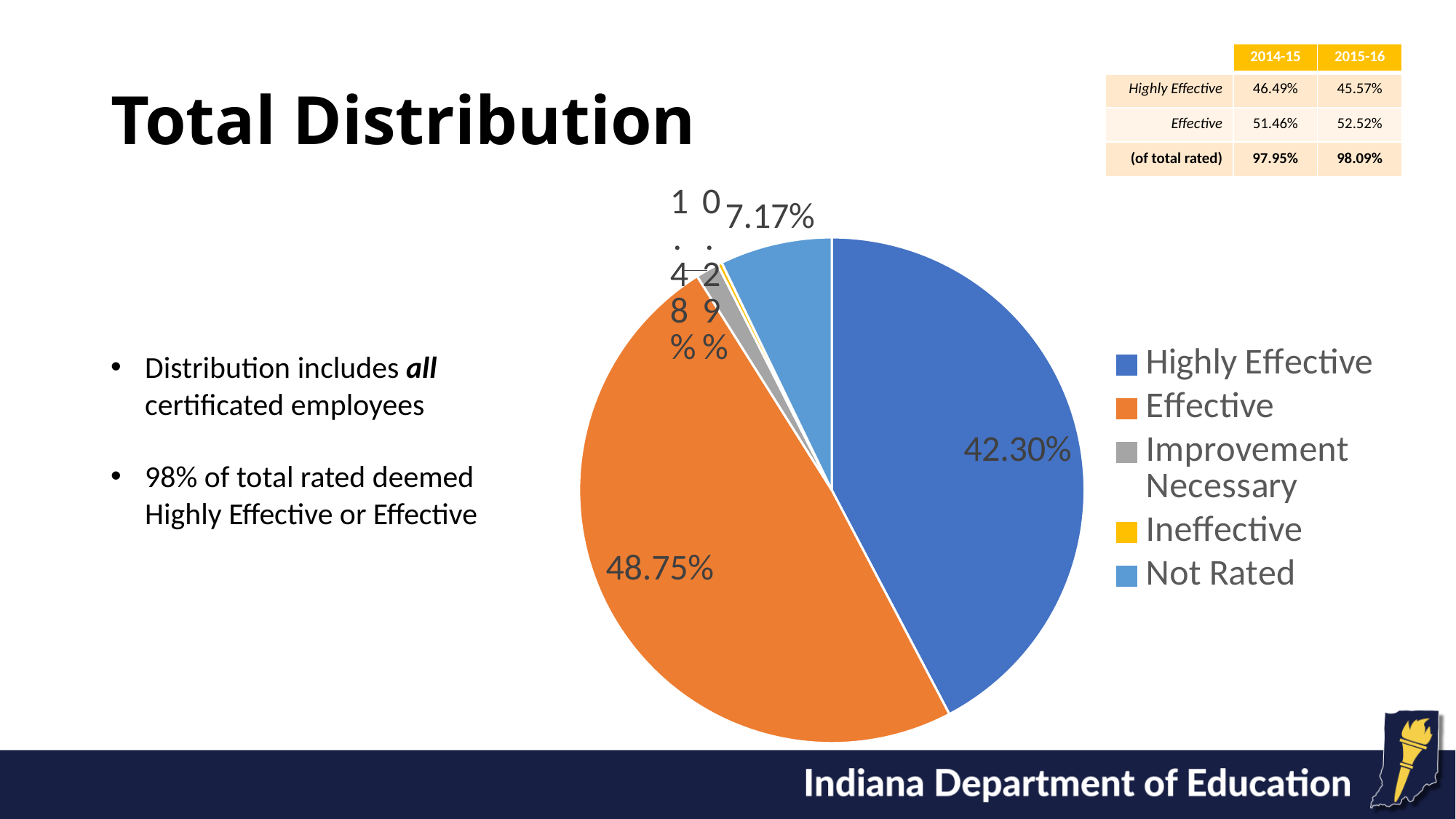
Which slice is larger in the pie chart, Highly Effective or Not Rated? Highly Effective What is the difference between the Effective and Highly Effective percentages in the pie chart? 6.45% What percentage of the pie chart is labelled for Improvement Necessary? 1.48% What colour is the Not Rated slice in the pie chart? Light blue Which category has the largest slice of the pie chart? Effective What colour is the Effective slice in the pie chart? Orange How many categories does the legend of the pie chart list? 5 What kind of chart is shown on the slide? Pie chart What percentage of the pie chart is labelled for Not Rated? 7.17% Which category has the smallest slice of the pie chart? Ineffective What percentage of the pie chart is labelled for Highly Effective? 42.30% What percentage of the pie chart is labelled for Effective? 48.75%